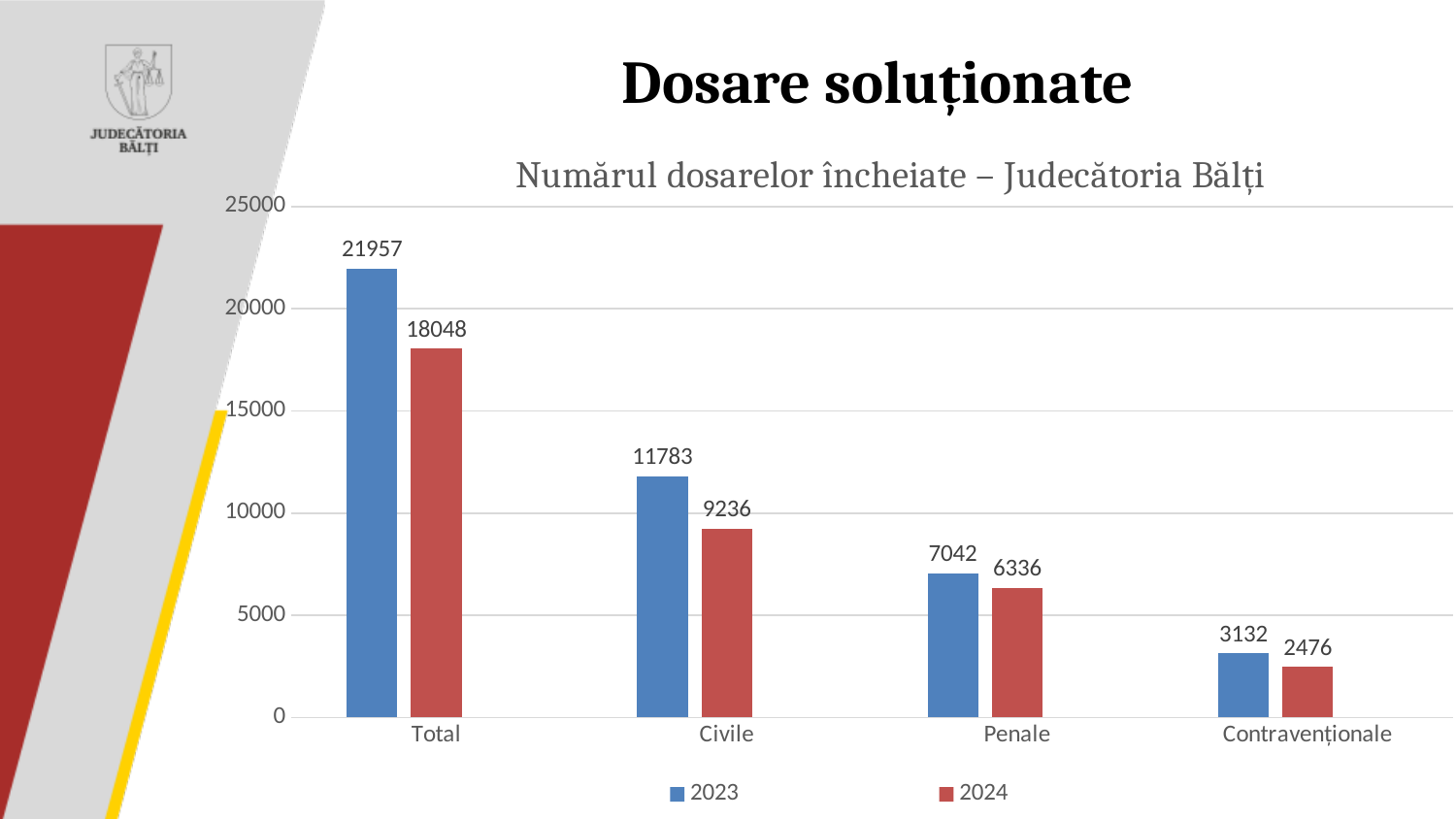
What is the value for Total in 2023? 21957 What is the value for Contravenționale in 2024? 2476 Which category has the lowest value in the 2023 series? Contravenționale What is the difference between the 2023 and 2024 values for Total? 3909 What is the difference between the 2023 and 2024 values for Penale? 706 What is the value for Penale in 2023? 7042 What is the value for Civile in 2024? 9236 What kind of chart is shown on the slide? Bar chart How many categories are shown on the x axis? 4 Which category has the highest value in the 2024 series? Total How many series does the legend list? 2 Which is larger for Civile: the 2023 value or the 2024 value? 2023